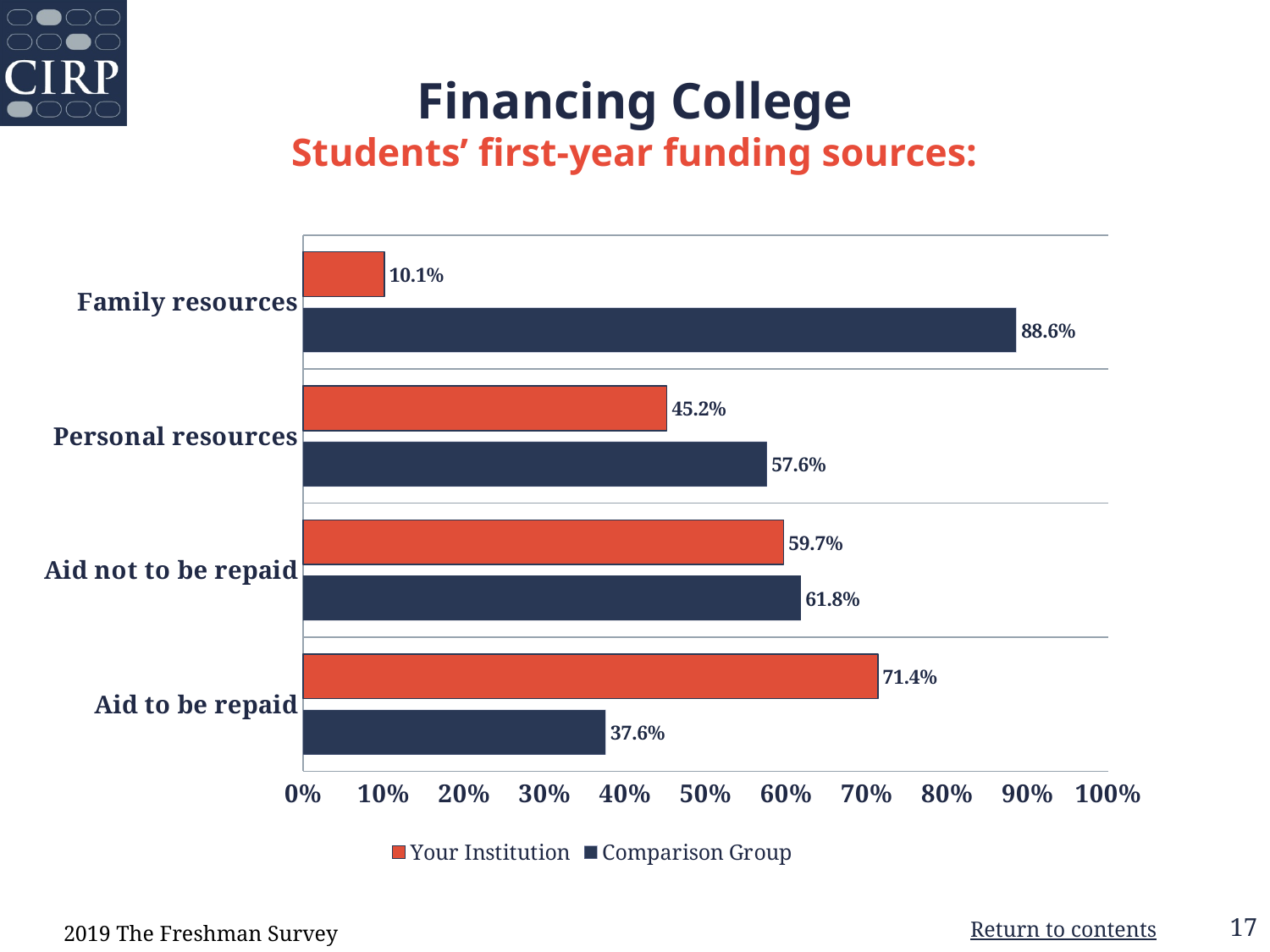
Is the value for Personal resources for the Comparison Group greater or less than 50%? greater What is the difference between the Comparison Group and Your Institution values for Family resources? 78.5% Which is larger for Aid to be repaid: Your Institution or the Comparison Group? Your Institution Which category has the lowest value for the Comparison Group? Aid to be repaid How many funding source categories are shown on the chart? 4 How many series does the legend list? 2 What is the value for Family resources for Your Institution? 10.1% Which category has the highest value for Your Institution? Aid to be repaid What kind of chart is shown on the slide? Bar chart What is the value for Aid to be repaid for the Comparison Group? 37.6% What is the value for Family resources for the Comparison Group? 88.6% What is the value for Personal resources for Your Institution? 45.2%